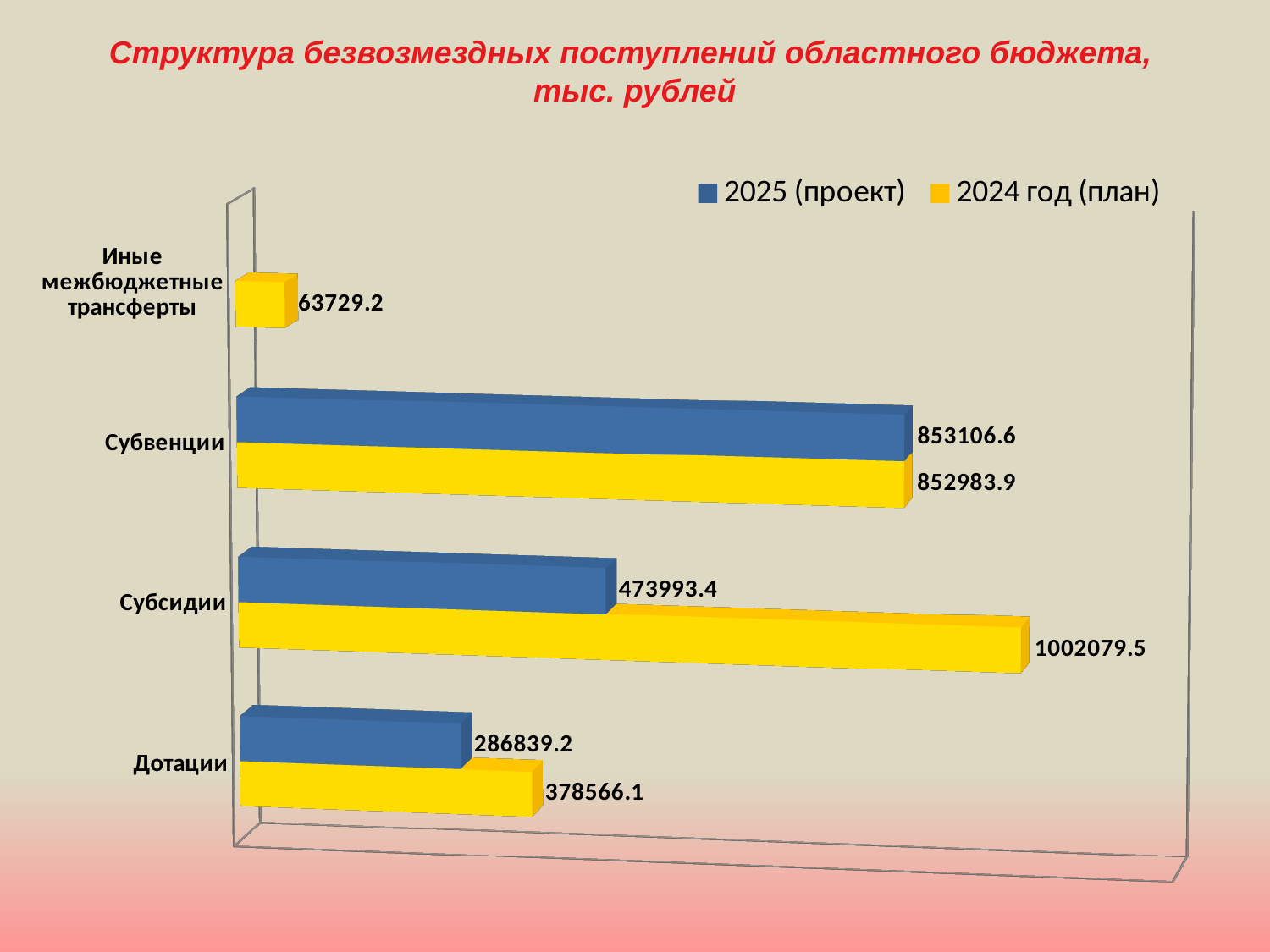
What is the value for Иные межбюджетные трансферты in the 2024 год (план) series? 63729.2 Which category has the highest value in the 2024 год (план) series? Субсидии What type of chart is shown on the slide? bar chart What is the value for Субсидии in the 2025 (проект) series? 473993.4 How many series does the legend list? 2 Which category has the highest value in the 2025 (проект) series? Субвенции What is the value for Субсидии in the 2024 год (план) series? 1002079.5 What is the value for Дотации in the 2025 (проект) series? 286839.2 How many categories are shown on the chart? 4 What is the difference between the 2024 год (план) and 2025 (проект) values for Субсидии? 528086.1 For Дотации, which series has the larger value: 2025 (проект) or 2024 год (план)? 2024 год (план) Which category has the lowest value in the 2024 год (план) series? Иные межбюджетные трансферты